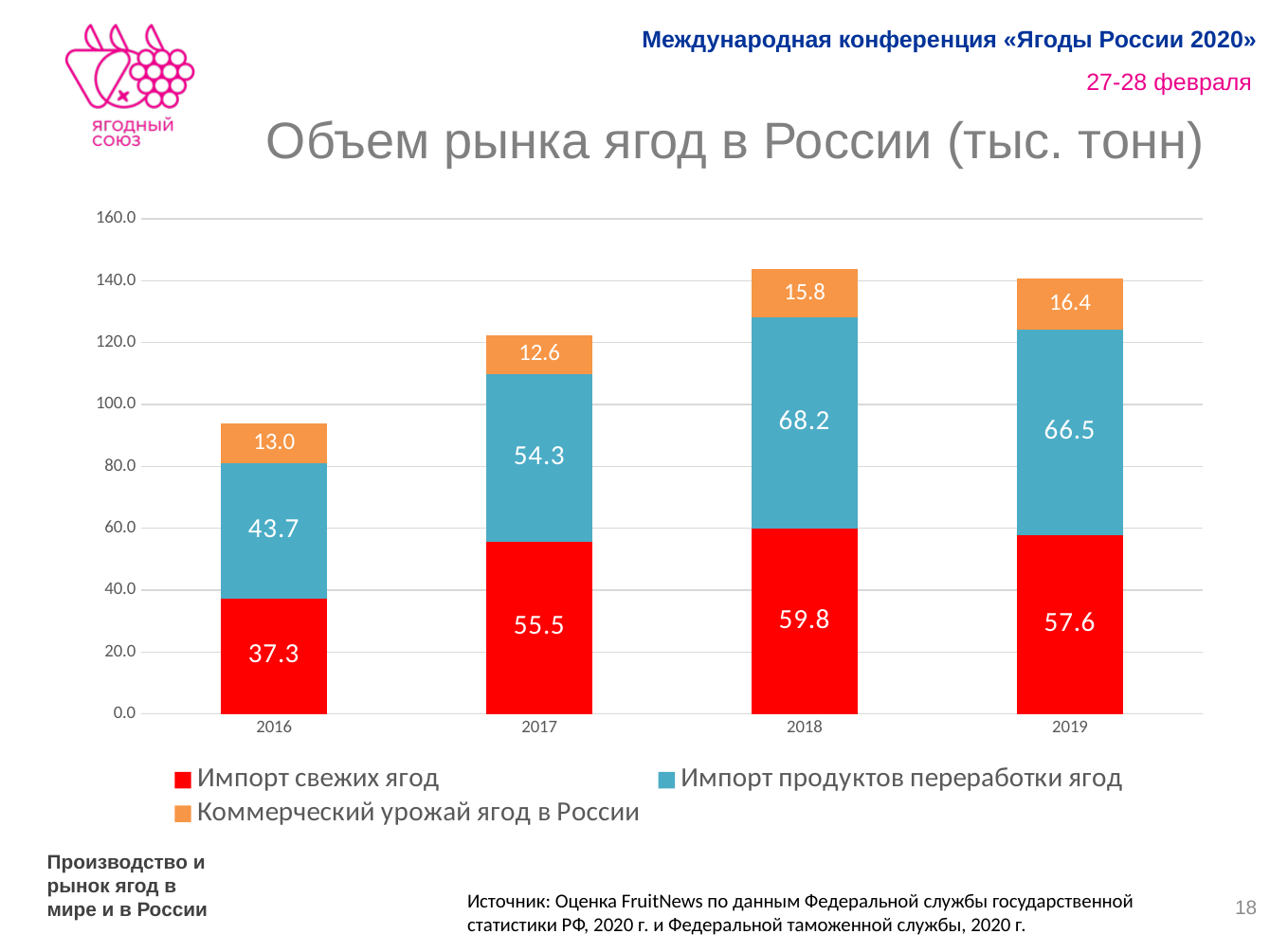
In which year is 'Импорт свежих ягод' the highest? 2018 What is the value of 'Импорт свежих ягод' in 2016? 37.3 What is the difference between 'Импорт продуктов переработки ягод' in 2019 and in 2016? 22.8 What is the total of the stacked bar for 2018? 143.8 What type of chart is shown on the slide? Stacked bar chart What is the value of 'Импорт продуктов переработки ягод' in 2018? 68.2 What is the total of the stacked bar for 2016? 94.0 Which is larger: 'Импорт свежих ягод' in 2017 or 'Импорт продуктов переработки ягод' in 2017? Импорт свежих ягод How many years are shown on the x axis? 4 In which year is 'Коммерческий урожай ягод в России' the lowest? 2017 What is the value of 'Коммерческий урожай ягод в России' in 2019? 16.4 How many series does the legend list? 3